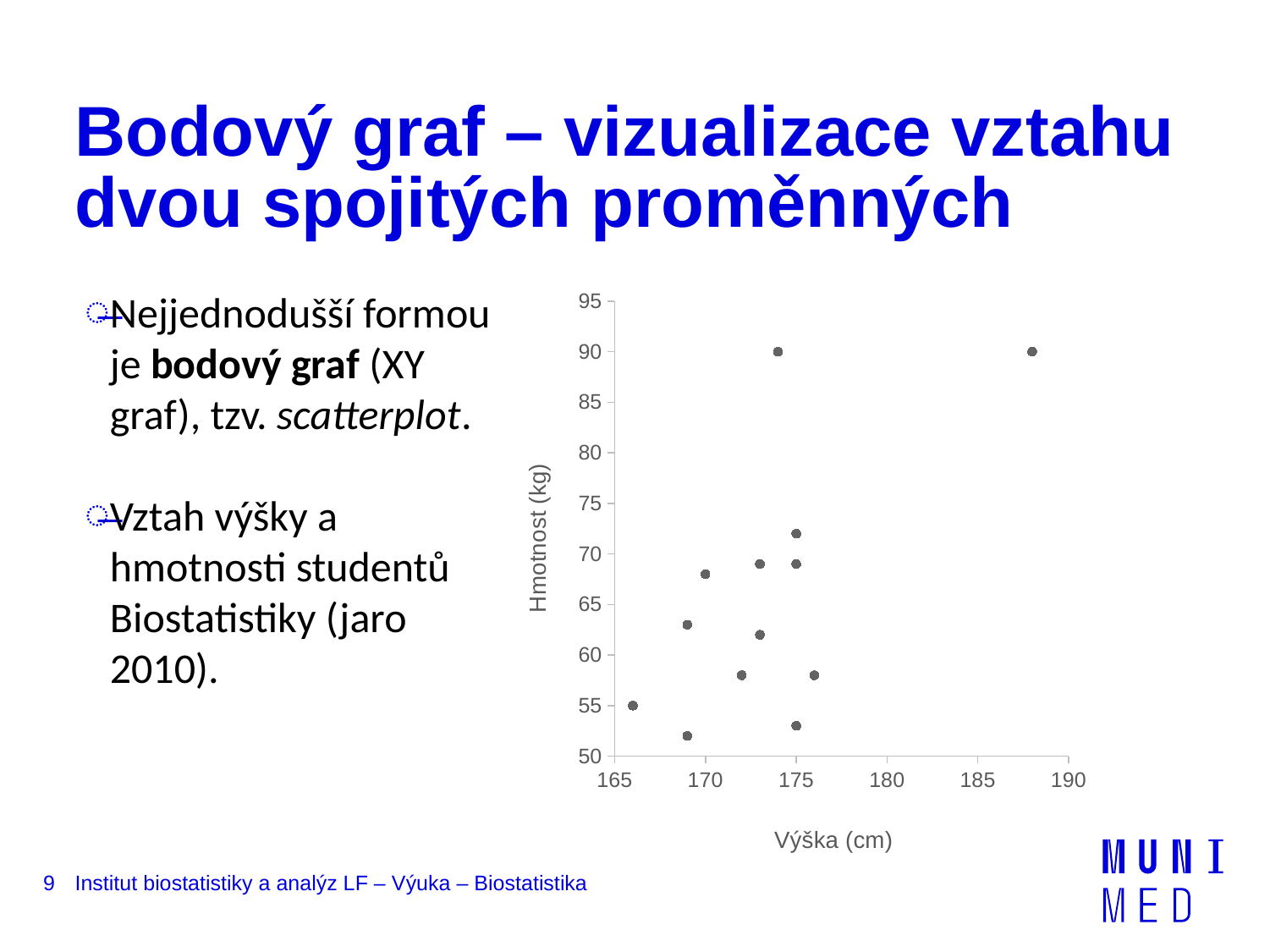
What kind of chart is shown on the slide? scatter plot How many data points are plotted in the scatter plot? 13 Is the lowest weight (Hmotnost) value plotted greater or less than 55? less Is the smallest height (Výška) value plotted greater or less than 170? less Is the largest height (Výška) value plotted greater or less than 185? greater What is the lowest value shown on the vertical (Hmotnost) axis? 50 What is the label of the vertical axis of the chart? Hmotnost (kg) What is the label of the horizontal axis of the chart? Výška (cm)